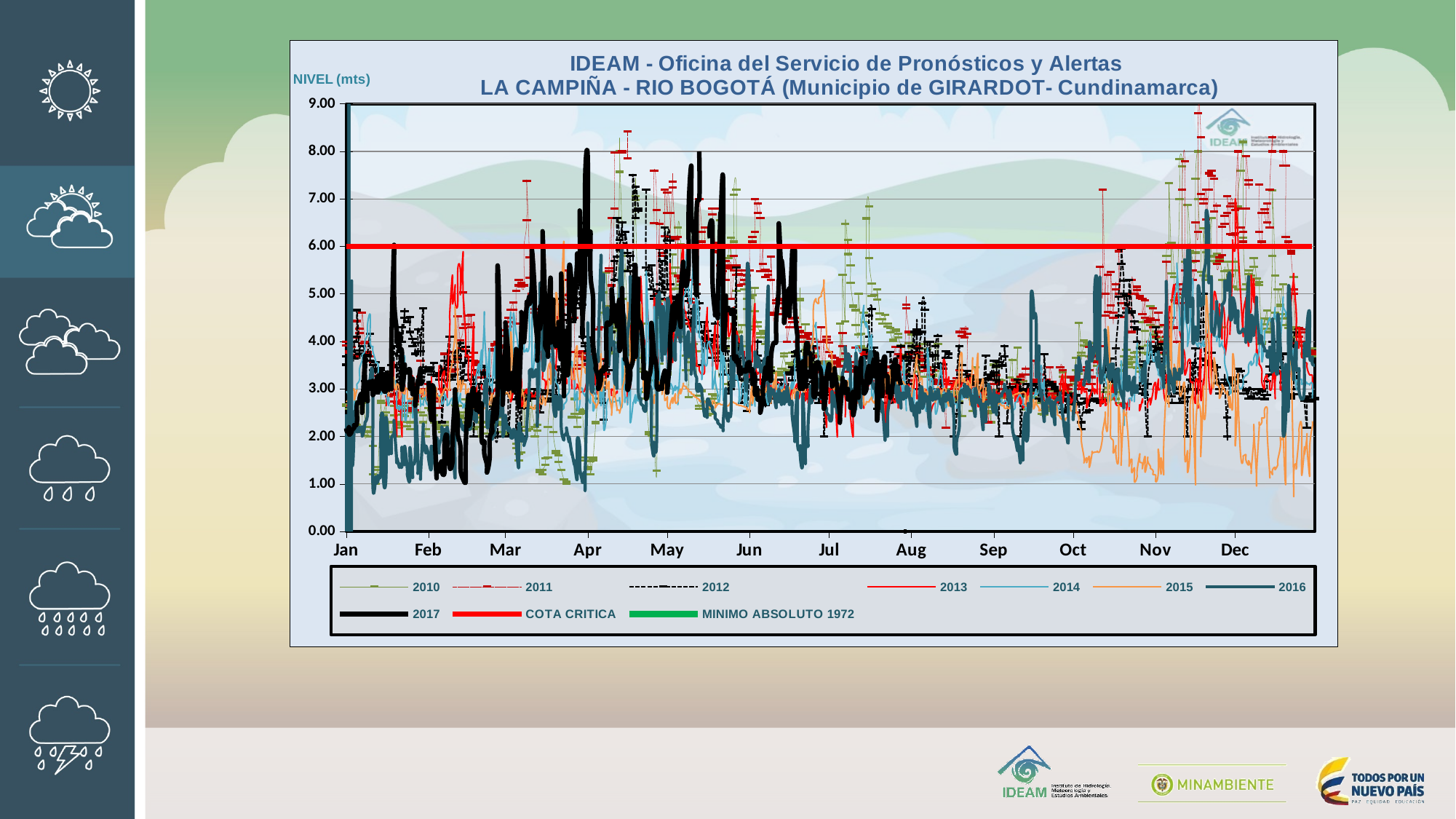
What kind of chart is shown on the slide? line chart Which year in the legend is drawn as a thick black line? 2017 How many months are labelled along the x axis? 12 Does the 2017 series rise above the COTA CRITICA line at any point during the year? yes What is the label of the y axis? NIVEL (mts) Is the 2015 series value in late December greater or less than 3.00? less At what level (mts) is the COTA CRITICA line drawn? 6.00 What is the highest value shown on the y axis? 9.00 Is the 2017 series value in early February greater or less than 2.00? less Is the peak value of the 2017 series in April greater or less than 7.00? greater How many series does the legend list? 10